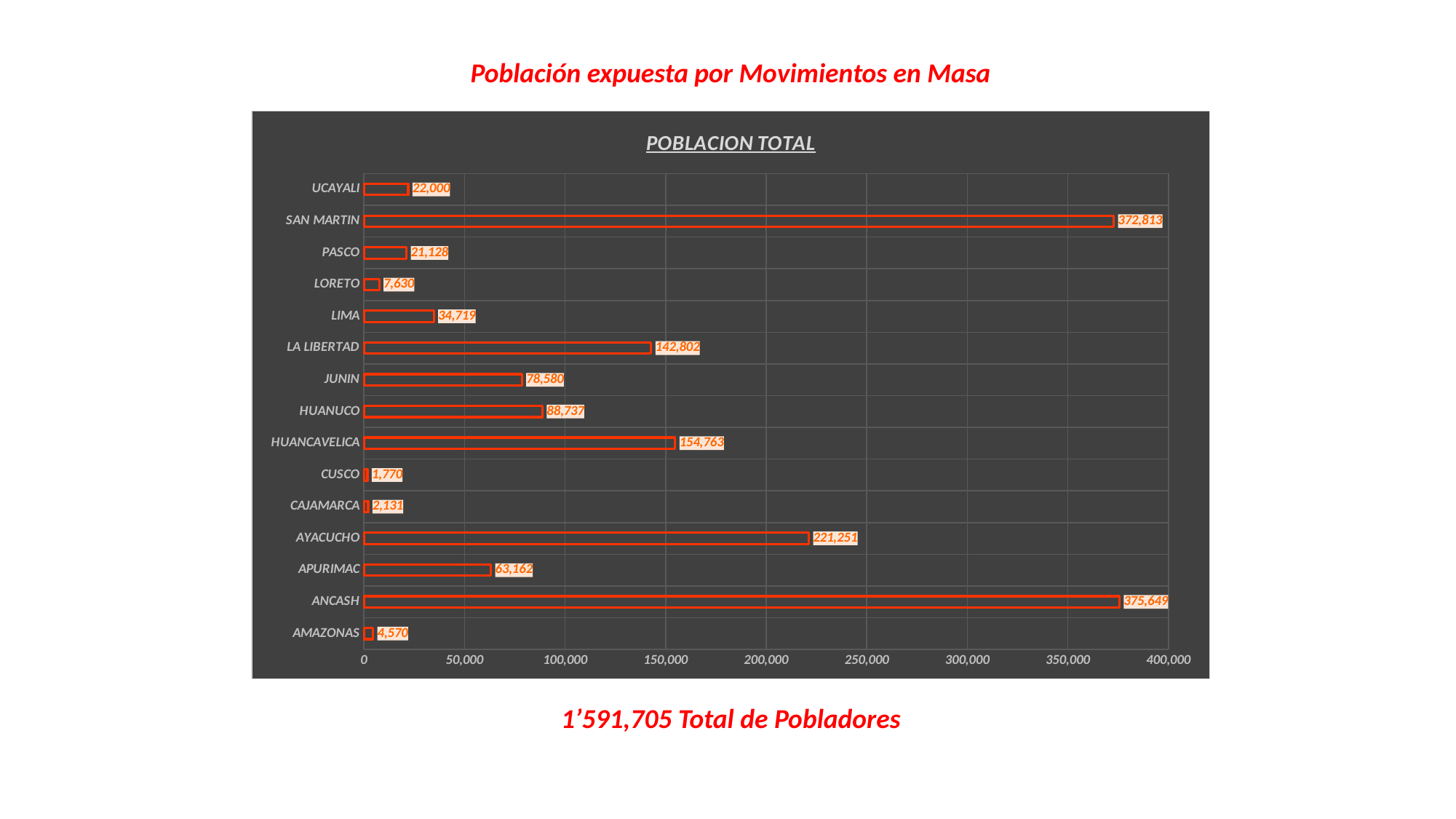
Which is larger, the value for HUANUCO or the value for JUNIN? HUANUCO What type of chart is shown on the slide? bar chart What is the difference between the values for AYACUCHO and HUANCAVELICA? 66,488 What is the title of the chart? POBLACION TOTAL What is the difference between the values for ANCASH and SAN MARTIN? 2,836 How many categories are shown in the chart? 15 Is the value for AYACUCHO greater or less than 200,000? greater What is the value for SAN MARTIN? 372,813 What is the value for LA LIBERTAD? 142,802 Which category has the highest value? ANCASH Which category has the lowest value? CUSCO What is the value for AMAZONAS? 4,570